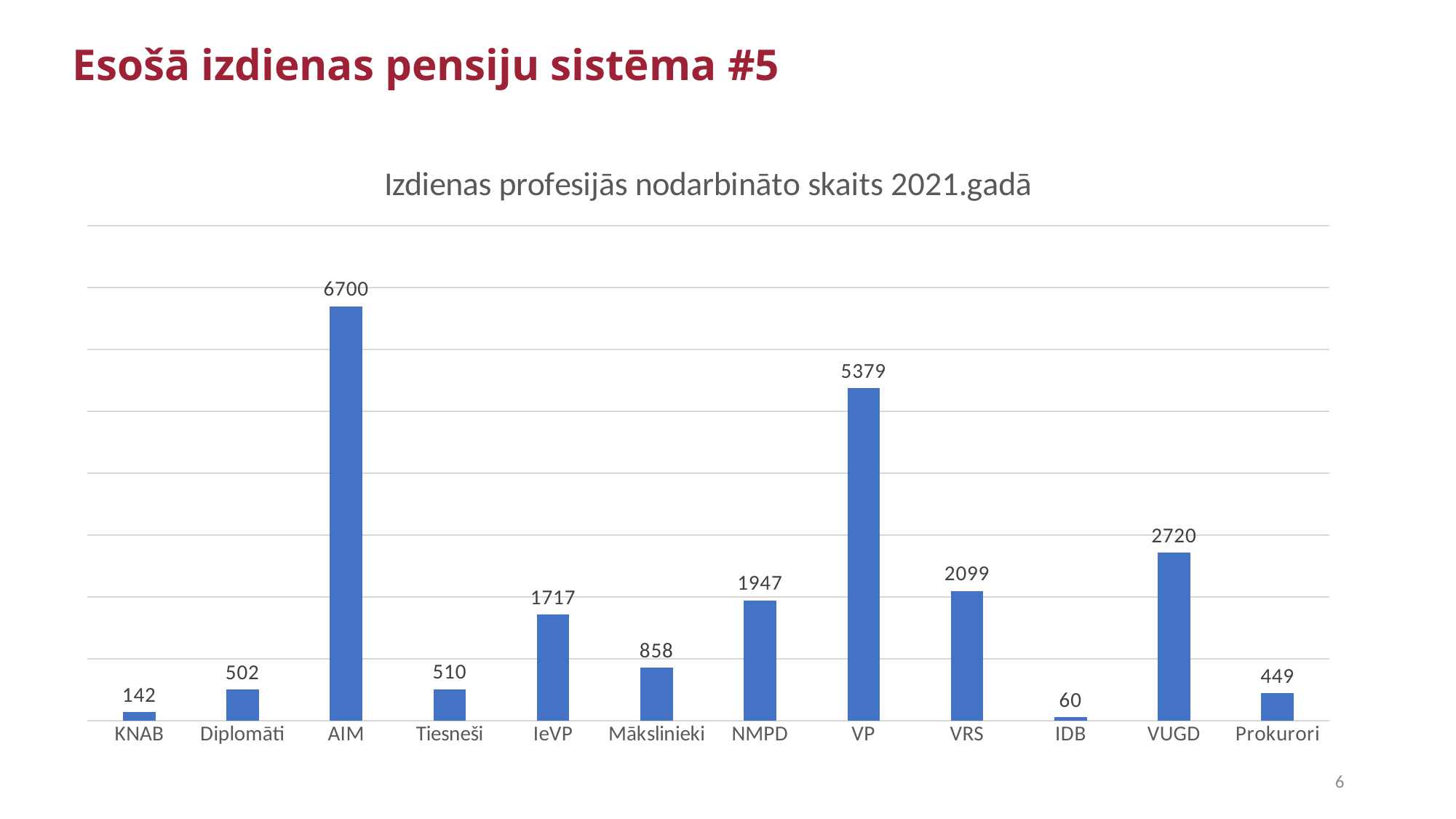
Which is larger, the value for NMPD or the value for IeVP? NMPD What is the value for Prokurori? 449 What is the difference between the values for VUGD and VRS? 621 What is the title of the chart? Izdienas profesijās nodarbināto skaits 2021.gadā Which is larger, the value for Diplomāti or the value for Mākslinieki? Mākslinieki What is the difference between the values for AIM and VP? 1321 Which category has the highest value? AIM What kind of chart is this? Bar chart What is the value for AIM? 6700 How many categories are shown on the x axis? 12 Which category has the lowest value? IDB What is the value for VRS? 2099